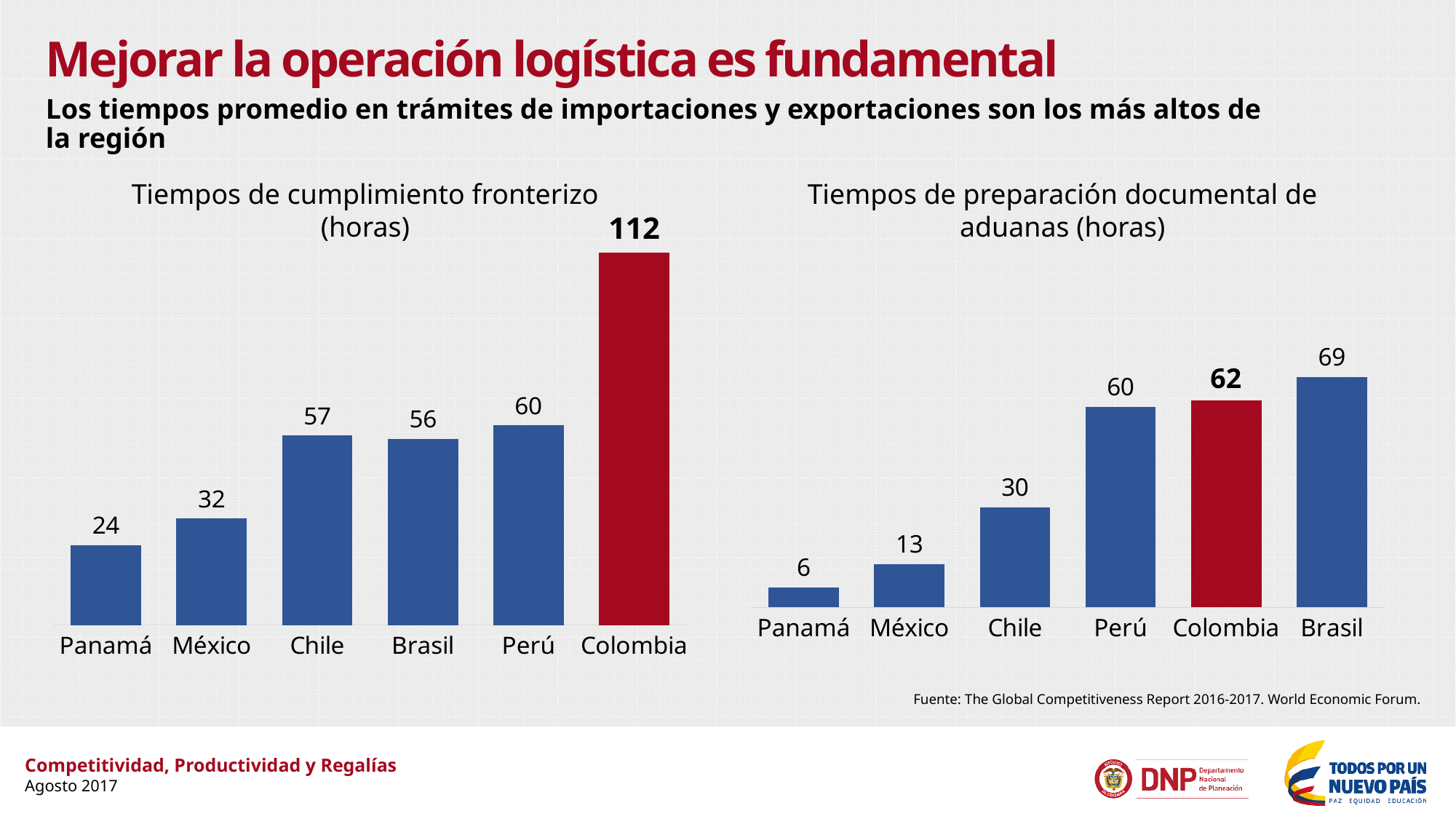
In the 'Tiempos de cumplimiento fronterizo (horas)' chart, what is the difference between Colombia and Perú? 52 In the 'Tiempos de cumplimiento fronterizo (horas)' chart, which country has the lowest value? Panamá In the 'Tiempos de preparación documental de aduanas (horas)' chart, what is the value for Panamá? 6 In the 'Tiempos de cumplimiento fronterizo (horas)' chart, what is the value for Colombia? 112 In the 'Tiempos de cumplimiento fronterizo (horas)' chart, what is the value for México? 32 In the 'Tiempos de preparación documental de aduanas (horas)' chart, what is the value for Colombia? 62 In the 'Tiempos de preparación documental de aduanas (horas)' chart, which country's bar is coloured red? Colombia In the 'Tiempos de preparación documental de aduanas (horas)' chart, which country has the highest value? Brasil In the 'Tiempos de cumplimiento fronterizo (horas)' chart, how many countries are shown? 6 In the 'Tiempos de preparación documental de aduanas (horas)' chart, what is the difference between Brasil and Chile? 39 In the 'Tiempos de preparación documental de aduanas (horas)' chart, which is larger, the value for Perú or the value for Chile? Perú What type of chart is the 'Tiempos de cumplimiento fronterizo (horas)' chart? Bar chart